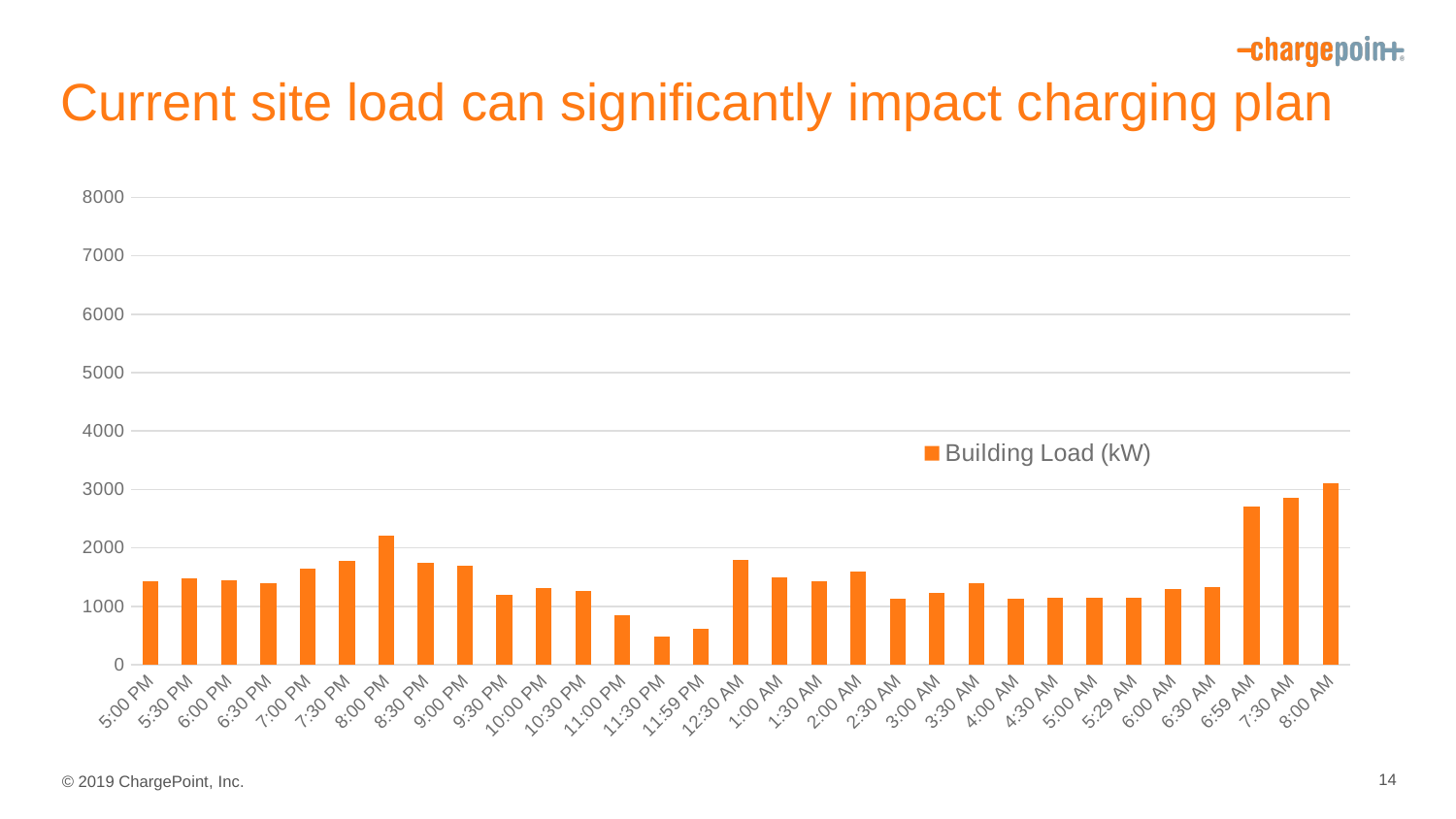
At which time is the building load lowest? 11:30 PM How many time categories are plotted along the x axis? 31 Is the building load at 11:00 PM greater or less than 1000? less What kind of chart is shown on the slide? Bar chart Is the building load at 11:30 PM greater or less than 1000? less Is the building load at 8:00 PM greater or less than 2000? greater At which time is the building load highest? 8:00 AM Which has the larger building load, 12:30 AM or 1:00 AM? 12:30 AM What is the name of the series shown in the legend? Building Load (kW) Which has the larger building load, 7:30 PM or 8:00 PM? 8:00 PM How many series does the legend list? 1